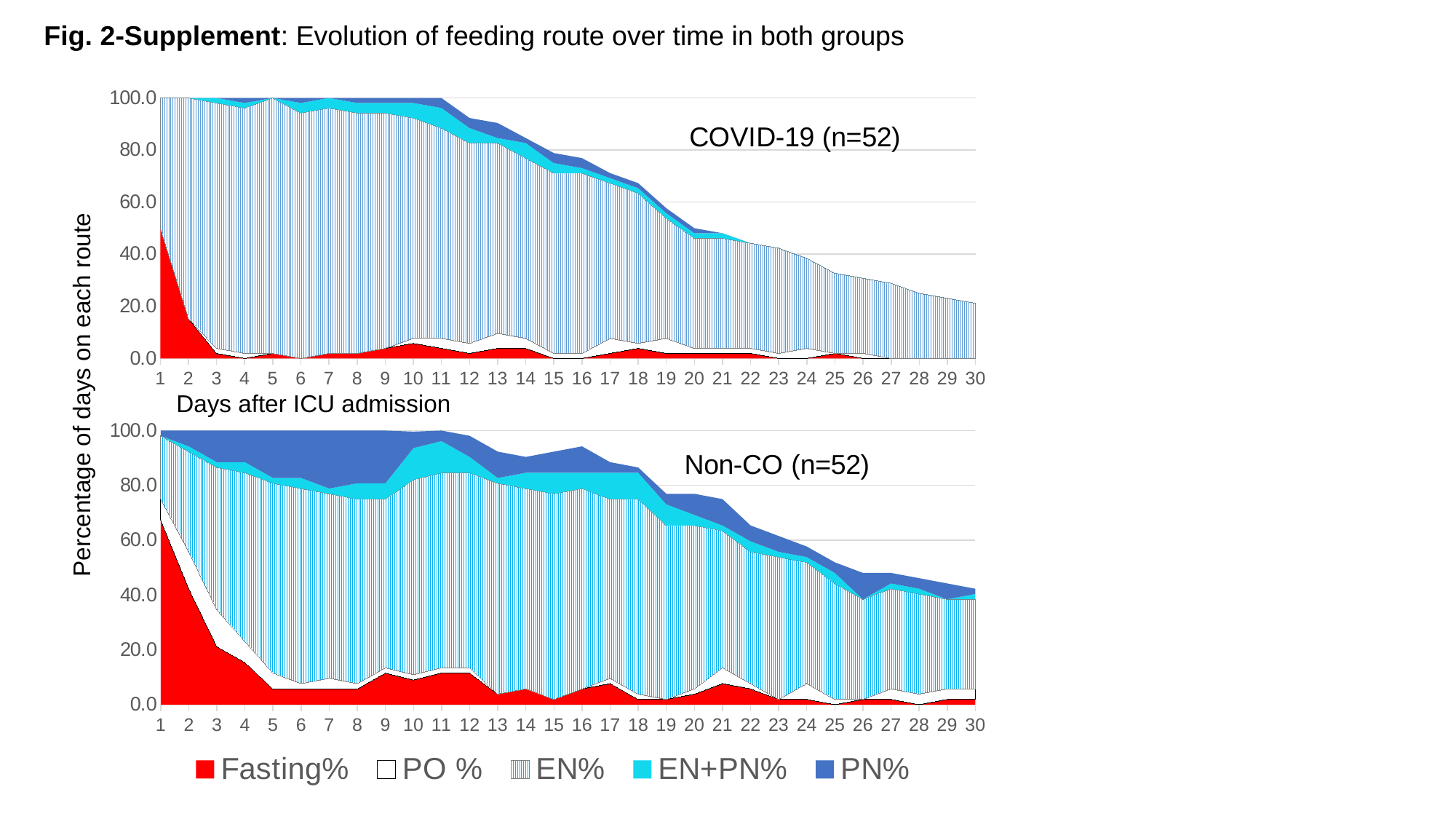
Which series is shown in red in the legend? Fasting% In the Non-CO (n=52) chart, is the Fasting% value on day 1 greater or less than 60? greater In the COVID-19 (n=52) chart, is the total stacked height on day 20 greater or less than 60? less What is the label of the y axis shared by both charts? Percentage of days on each route On day 1, which chart shows the larger Fasting% value, COVID-19 (n=52) or Non-CO (n=52)? Non-CO (n=52) In the COVID-19 (n=52) chart, is the Fasting% value on day 1 greater or less than 40? greater In the COVID-19 (n=52) chart, does the total stacked height rise or fall from day 1 to day 30? fall How many series does the legend list? 5 How many days are shown along the x axis of the Non-CO (n=52) chart? 30 On day 30, which chart has the larger total stacked height, COVID-19 (n=52) or Non-CO (n=52)? Non-CO (n=52) What kind of chart is used for the COVID-19 (n=52) panel? stacked area chart